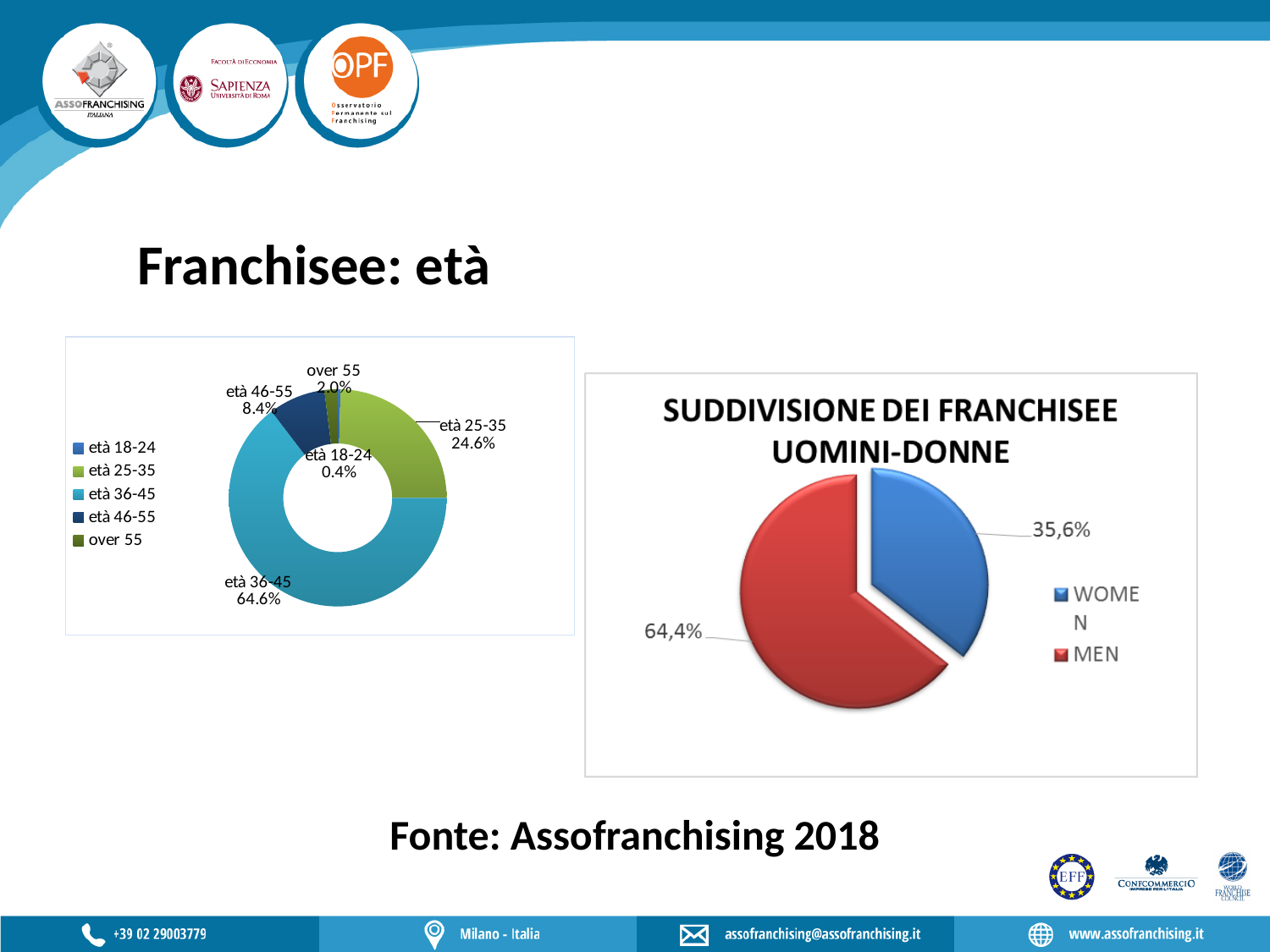
In the left doughnut chart on age, what is the value for età 25-35? 24.6% How many age categories does the legend of the left doughnut chart list? 5 What kind of chart is the one titled 'SUDDIVISIONE DEI FRANCHISEE UOMINI-DONNE'? pie chart In the left doughnut chart on age, what is the value for over 55? 2.0% In the left doughnut chart on age, what is the difference between età 36-45 and età 25-35? 40.0% In the left doughnut chart on age, which is larger, età 46-55 or over 55? età 46-55 In the left doughnut chart on age, what is the value for età 36-45? 64.6% In the chart titled 'SUDDIVISIONE DEI FRANCHISEE UOMINI-DONNE', what is the share for MEN? 64,4% In the chart titled 'SUDDIVISIONE DEI FRANCHISEE UOMINI-DONNE', what is the share for WOMEN? 35,6% In the left doughnut chart on age, which age group has the largest share? età 36-45 In the left doughnut chart on age, which age group has the smallest share? età 18-24 In the chart titled 'SUDDIVISIONE DEI FRANCHISEE UOMINI-DONNE', which colour represents MEN? red